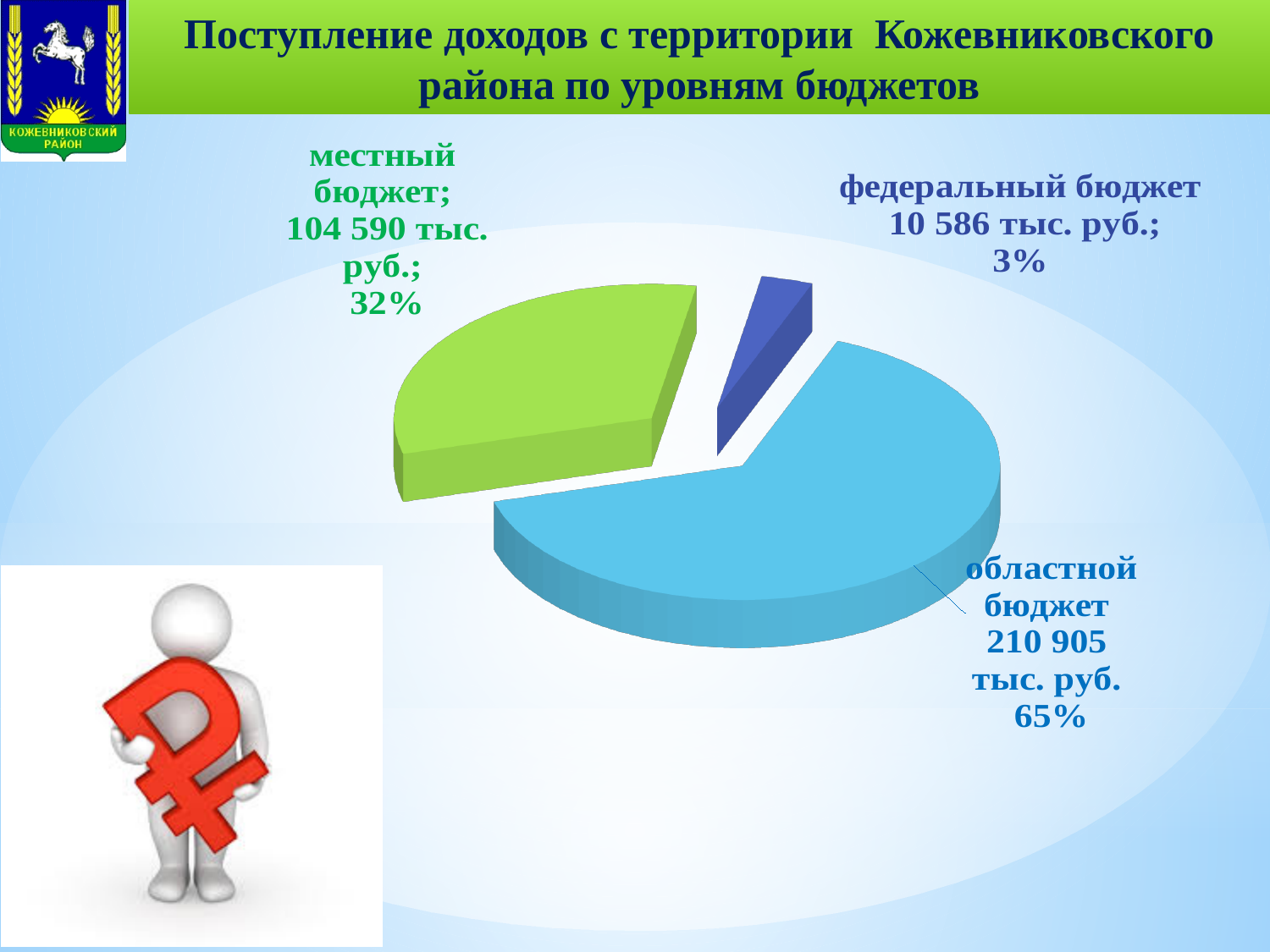
Which is larger, the value for местный бюджет or the value for федеральный бюджет? местный бюджет Which budget level has the largest share of the pie? областной бюджет What colour is the slice for областной бюджет? light blue What share of the pie does федеральный бюджет represent? 3% What share of the pie does местный бюджет represent? 32% Which budget level has the smallest share of the pie? федеральный бюджет What is the value for федеральный бюджет? 10 586 тыс. руб. How many slices does the pie chart have? 3 What kind of chart is shown on the slide? pie chart What is the difference between the values for областной бюджет and местный бюджет? 106 315 тыс. руб. What is the value for местный бюджет? 104 590 тыс. руб. What is the value for областной бюджет? 210 905 тыс. руб.